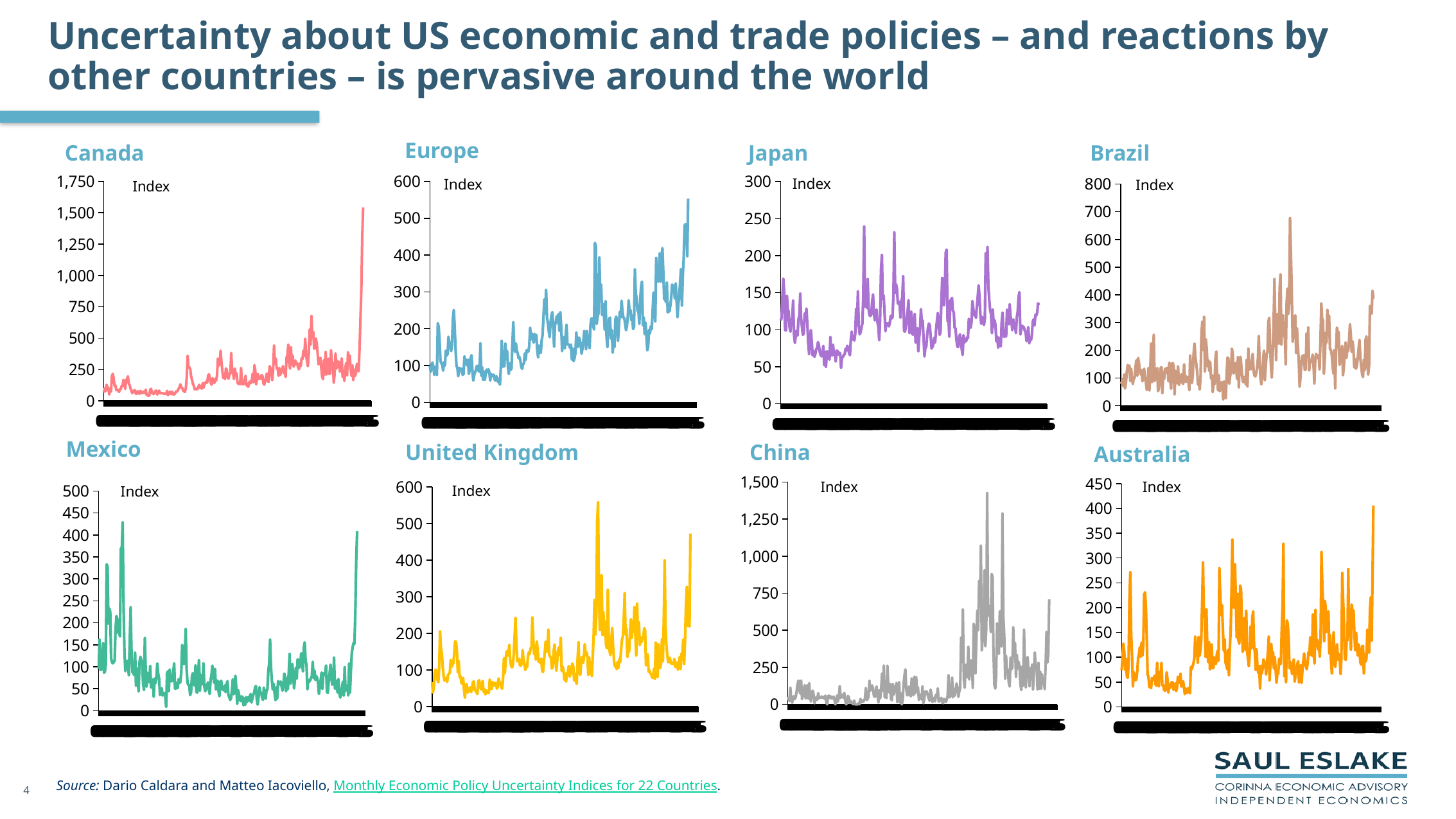
What kind of chart is the Canada chart? Line chart On the Europe chart, does the index generally rise or fall from left to right? rise On the Europe chart, is the highest value greater or less than 500? greater On the Mexico chart, is the highest peak greater or less than 400? greater How many country charts are shown on the slide? 8 On the Canada chart, is the final spike value greater or less than 1,250? greater What is the highest tick shown on the y axis of the Canada chart? 1,750 How many lines are plotted on the Japan chart? 1